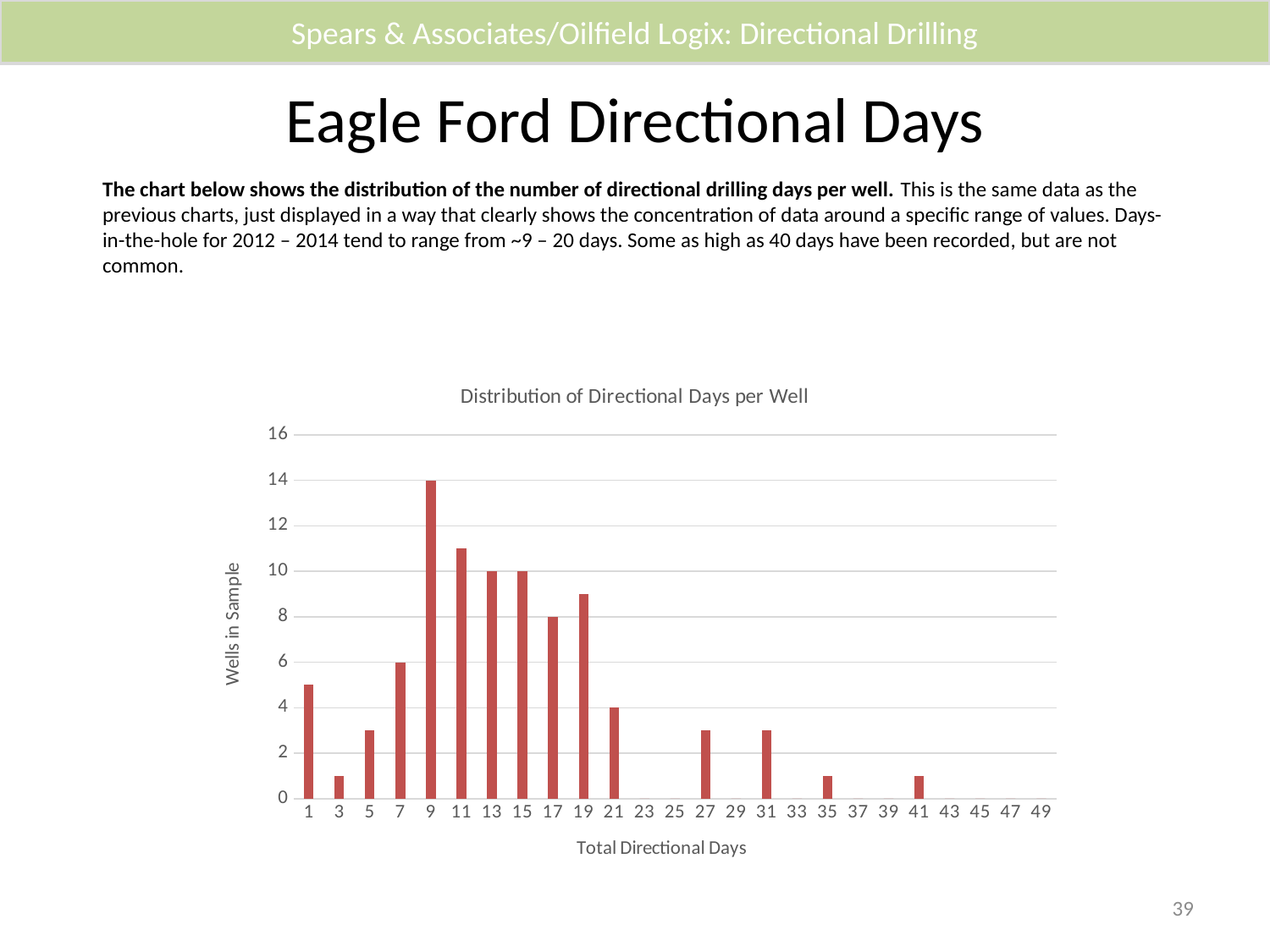
Which has more wells in sample: 27 total directional days or 35 total directional days? 27 How many wells in sample are shown for 9 total directional days? 14 Which has more wells in sample: 1 total directional day or 3 total directional days? 1 Is the number of wells in sample for 11 total directional days greater or less than 10? greater What is the label of the vertical axis? Wells in Sample How many wells in sample are shown for 17 total directional days? 8 Is the number of wells in sample for 19 total directional days greater or less than 10? less What kind of chart is shown on the slide? bar chart What is the title of the chart? Distribution of Directional Days per Well Which value of Total Directional Days has the highest number of wells in sample? 9 What is the difference in wells in sample between 9 and 17 total directional days? 6 How many wells in sample are shown for 21 total directional days? 4